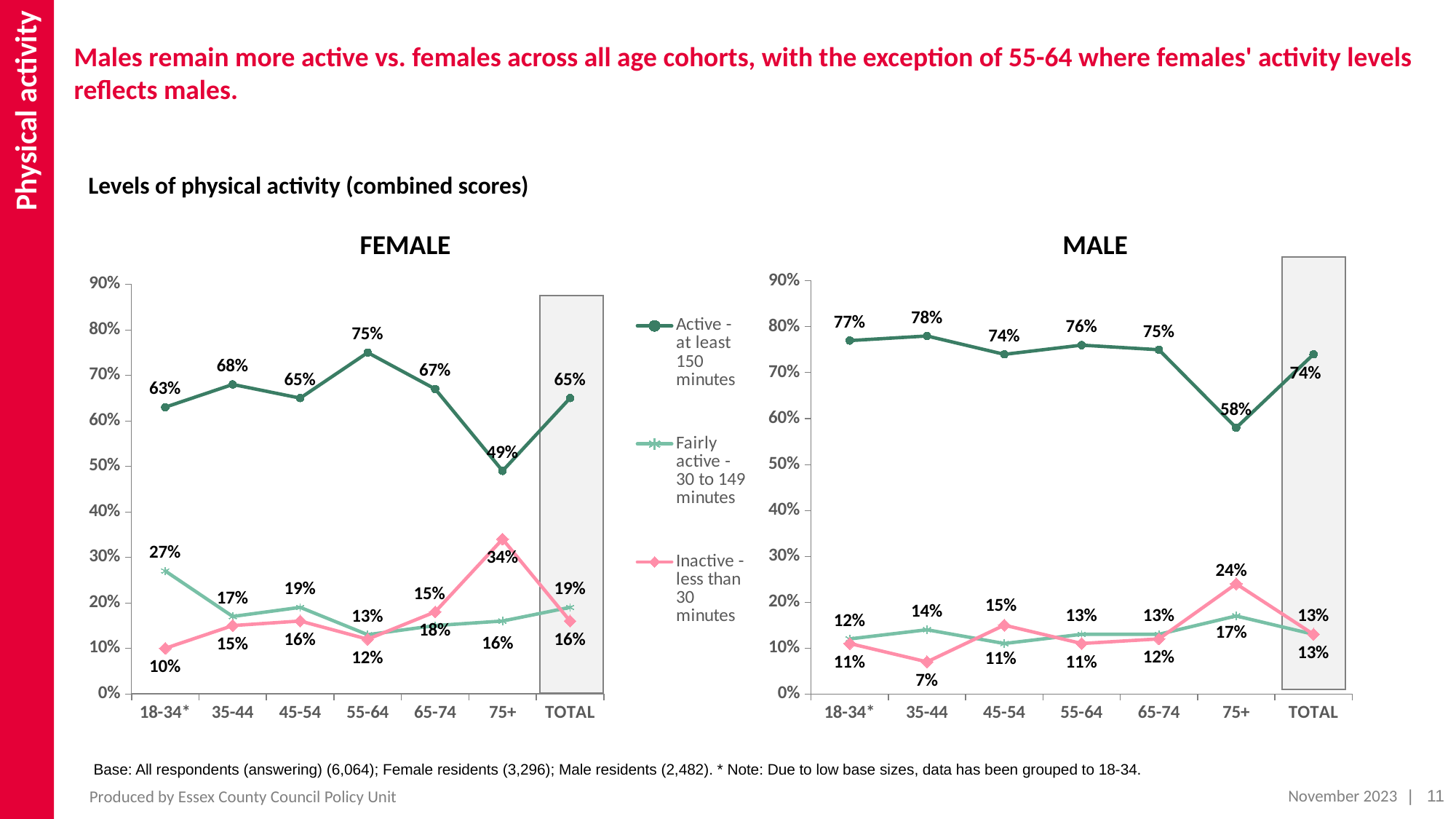
What kind of chart is the FEMALE chart? line chart In the FEMALE chart, what is the value for Active - at least 150 minutes in the 55-64 age group? 75% Which is larger: the TOTAL Active value in the FEMALE chart or the TOTAL Active value in the MALE chart? MALE In the FEMALE chart, which age group has the lowest value for Active - at least 150 minutes? 75+ In the FEMALE chart, what is the difference between the Active values for 55-64 and 75+? 26% How many categories are shown on the x axis of the MALE chart? 7 How many series does the legend list? 3 In the MALE chart, what is the difference between the Inactive values for 75+ and 35-44? 17% In the MALE chart, which age group has the highest value for Active - at least 150 minutes? 35-44 In the FEMALE chart, is the Inactive value for 75+ greater or less than 30%? greater In the MALE chart, what is the value for Inactive - less than 30 minutes in the 75+ age group? 24% In the MALE chart, what is the TOTAL value for Active - at least 150 minutes? 74%